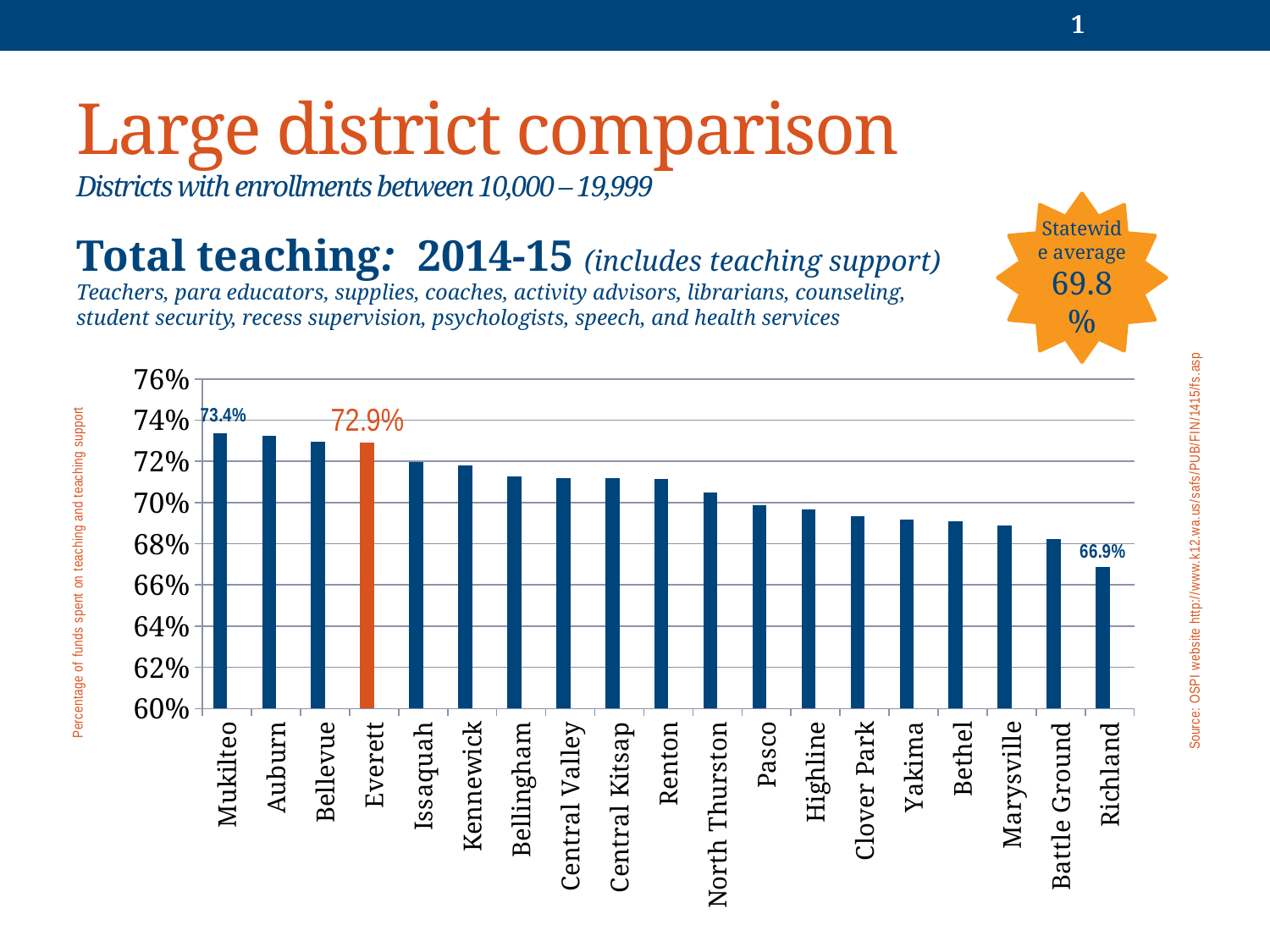
What is the value for Mukilteo? 73.4% Which is larger, the value for Bellevue or the value for Yakima? Bellevue What is the value for Richland? 66.9% Which district has the highest percentage of funds spent on teaching and teaching support? Mukilteo How many districts are shown in the chart? 19 What is the difference between Mukilteo's value and Everett's value? 0.5% What is the value for Everett? 72.9% What kind of chart is shown on the slide? bar chart Is the value for Renton greater or less than 70%? greater Is the value for Marysville greater or less than 70%? less What is the difference between Everett's value and Richland's value? 6.0% Which district has the lowest percentage of funds spent on teaching and teaching support? Richland